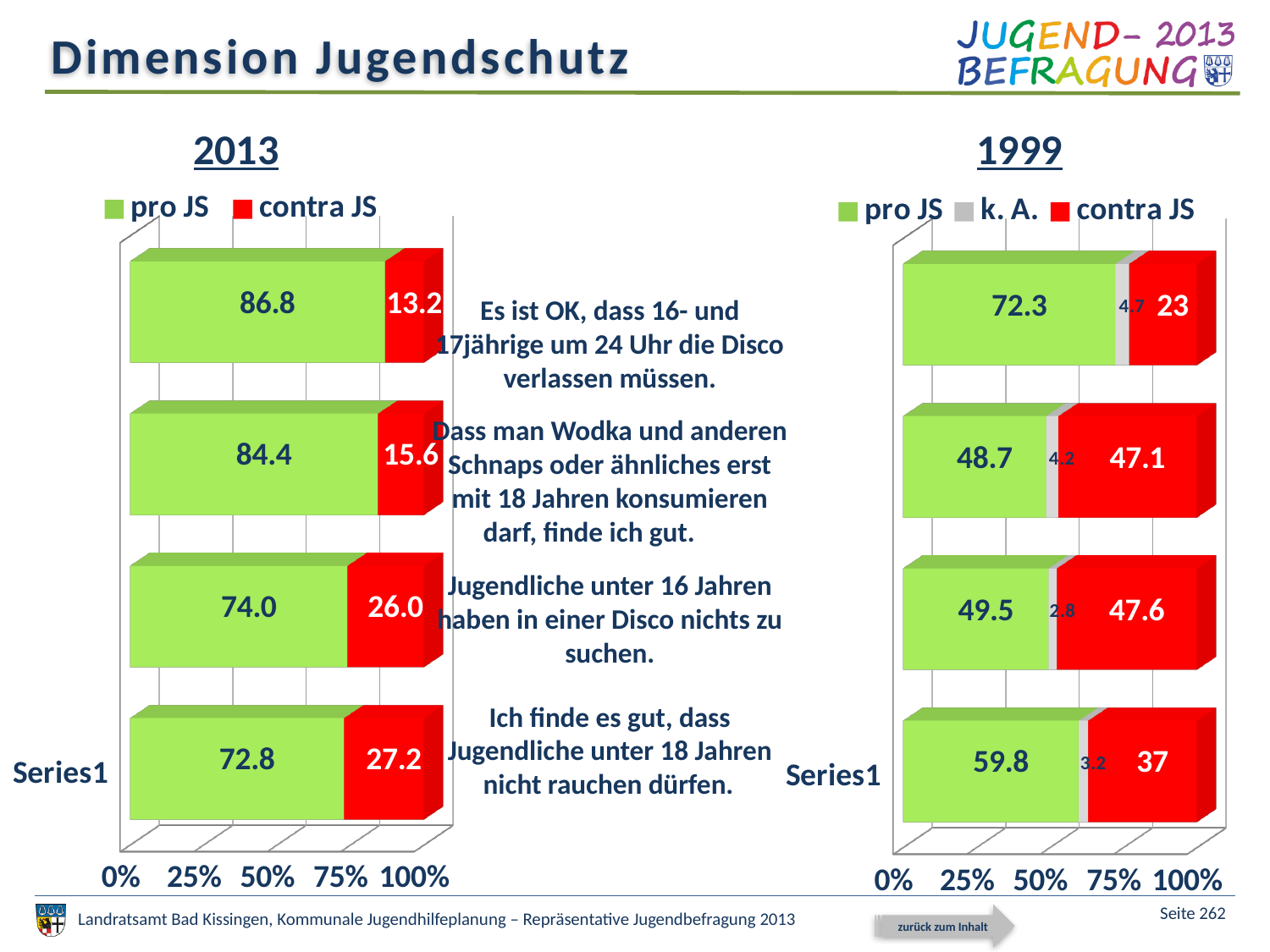
In the 1999 chart, what is the contra JS value for the statement "Ich finde es gut, dass Jugendliche unter 18 Jahren nicht rauchen dürfen"? 37 In the 2013 chart, what is the difference between the pro JS and contra JS values for the statement about under-18s not being allowed to smoke? 45.6 In the 1999 chart, what is the total of the stacked bar for the statement about 16- and 17-year-olds leaving the disco at 24 Uhr? 100 How many bars does the 2013 chart show? 4 In the 1999 chart, which is larger: the contra JS value for the Wodka/Schnaps statement or the contra JS value for the statement about under-16s in a disco? the statement about under-16s in a disco (47.6) In the 2013 chart, what is the pro JS value for the statement "Jugendliche unter 16 Jahren haben in einer Disco nichts zu suchen"? 74.0 In the 2013 chart, is the pro JS value for the Wodka/Schnaps statement greater or less than 75%? greater In the 1999 chart, which statement has the lowest pro JS value? Dass man Wodka und anderen Schnaps oder ähnliches erst mit 18 Jahren konsumieren darf, finde ich gut. How many series does the legend of the 1999 chart list? 3 What kind of chart is the 2013 chart on the left? bar chart In the 2013 chart, which statement has the highest pro JS value? Es ist OK, dass 16- und 17jährige um 24 Uhr die Disco verlassen müssen. In the 1999 chart, what is the k. A. value for the statement about consuming Wodka and Schnaps only from 18 years? 4.2